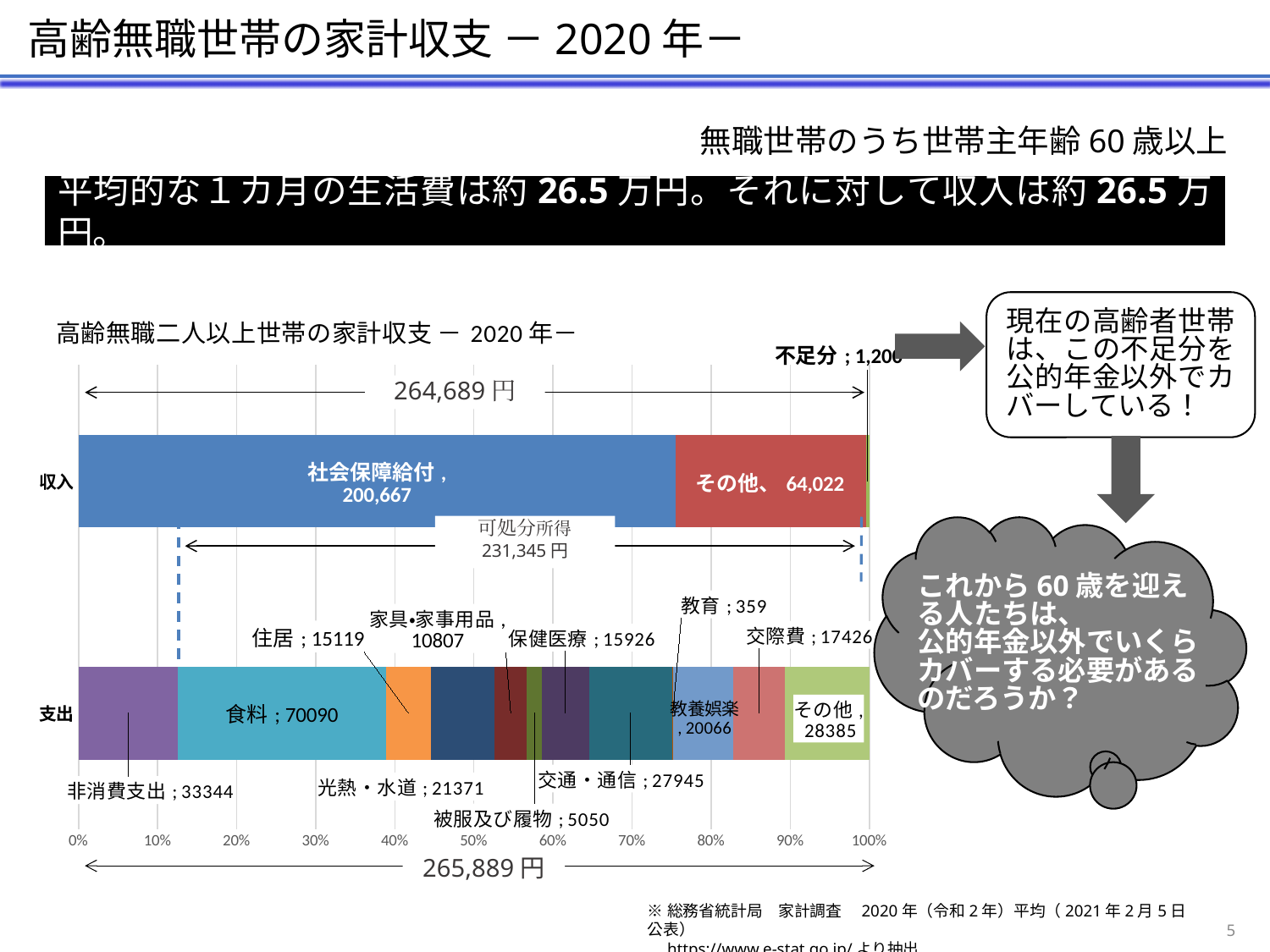
What is the value of 可処分所得 shown on the chart? 231,345円 How many categories make up the 支出 bar? 12 Which is larger in the 支出 bar, 交通・通信 or 光熱・水道? 交通・通信 What is the difference between 社会保障給付 and その他 in the 収入 bar? 136,645 What is the total of the 支出 bar? 265,889円 What is the title of the chart? 高齢無職二人以上世帯の家計収支 － 2020年－ Which category in the 支出 bar has the largest value? 食料 Which category in the 支出 bar has the smallest value? 教育 What is the value of 教育 in the 支出 bar? 359 What is the value of 社会保障給付 in the 収入 bar? 200,667 What is the value of 食料 in the 支出 bar? 70090 What kind of chart is shown on the slide? Stacked bar chart